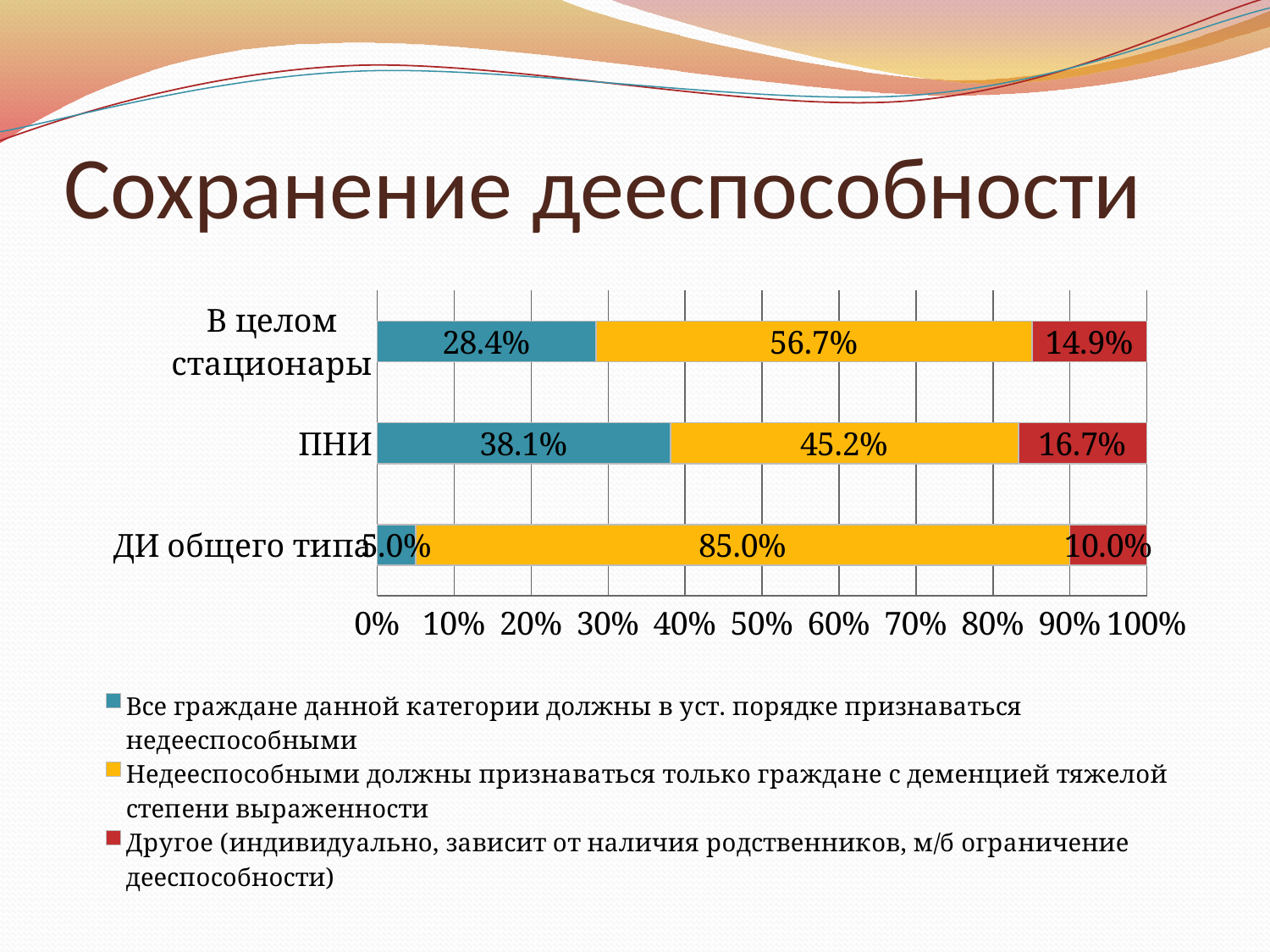
How many categories are plotted on the chart? 3 What is the value of the blue segment (Все граждане данной категории должны в уст. порядке признаваться недееспособными) for В целом стационары? 28.4% Which category has the highest value for the yellow segment (Недееспособными должны признаваться только граждане с деменцией тяжелой степени выраженности)? ДИ общего типа What is the title of the slide containing the chart? Сохранение дееспособности What is the value of the yellow segment (Недееспособными должны признаваться только граждане с деменцией тяжелой степени выраженности) for ПНИ? 45.2% What is the value of the red segment (Другое) for ДИ общего типа? 10.0% What type of chart is shown on the slide? stacked bar chart Which is larger: the red segment (Другое) for ПНИ or for В целом стационары? ПНИ What is the difference between the blue segment values for ПНИ and В целом стационары? 9.7% What is the total of the stacked bar for ПНИ? 100.0% Which category has the lowest value for the blue segment (Все граждане данной категории должны в уст. порядке признаваться недееспособными)? ДИ общего типа How many series does the legend list? 3